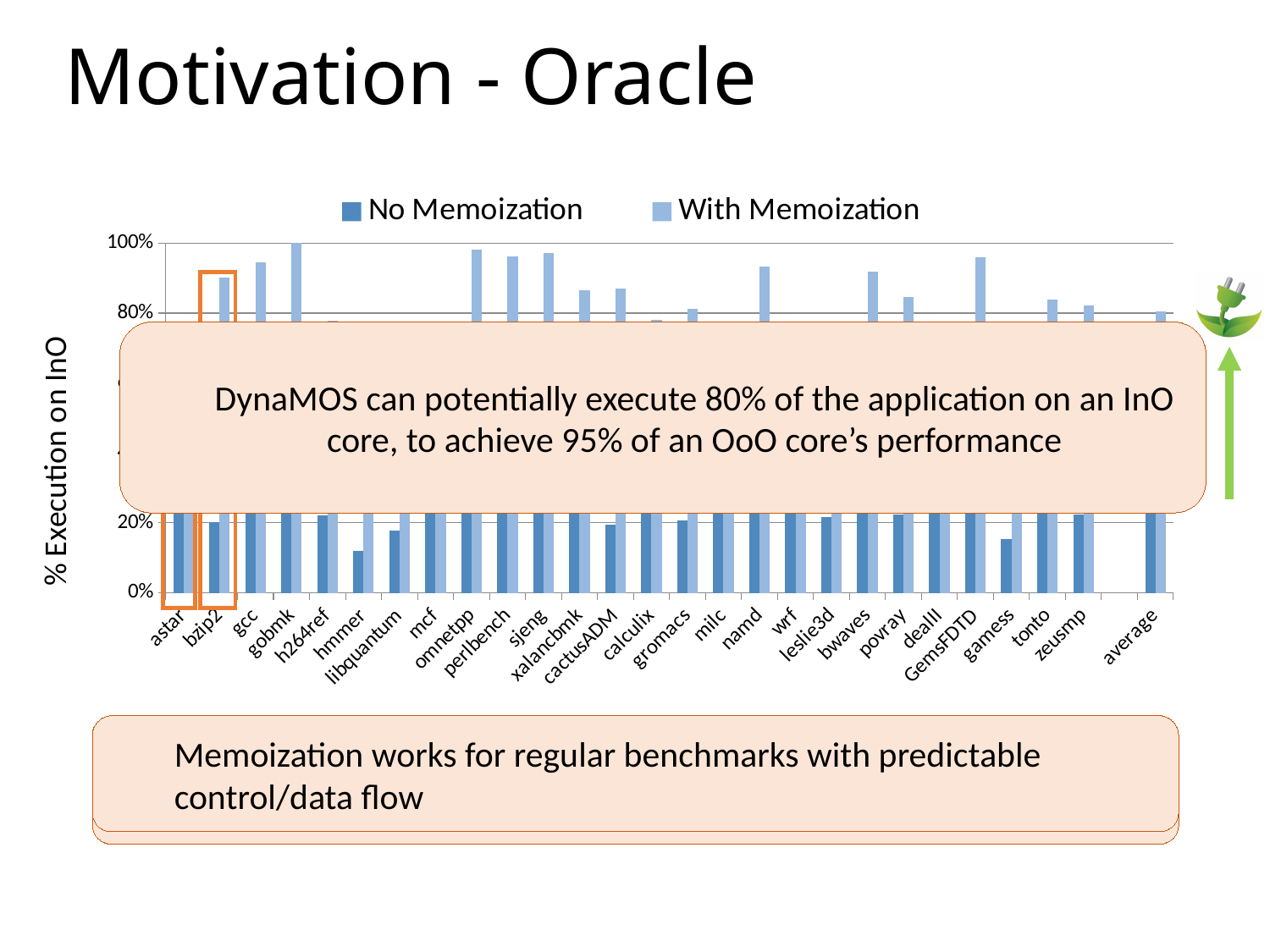
Is the With Memoization value for namd greater or less than 80%? greater Is the No Memoization value for hmmer greater or less than 20%? less What is the label on the vertical axis of the chart? % Execution on InO How many benchmark categories (including average) are shown on the x axis? 27 How many series does the chart legend list? 2 What are the two series named in the chart legend? No Memoization and With Memoization What kind of chart is shown on the slide? bar chart Which benchmark has the lowest No Memoization value? hmmer Is the No Memoization value for gamess greater or less than 20%? less Which is larger, the With Memoization value for gcc or for tonto? gcc Which is larger, the No Memoization value for hmmer or for libquantum? libquantum